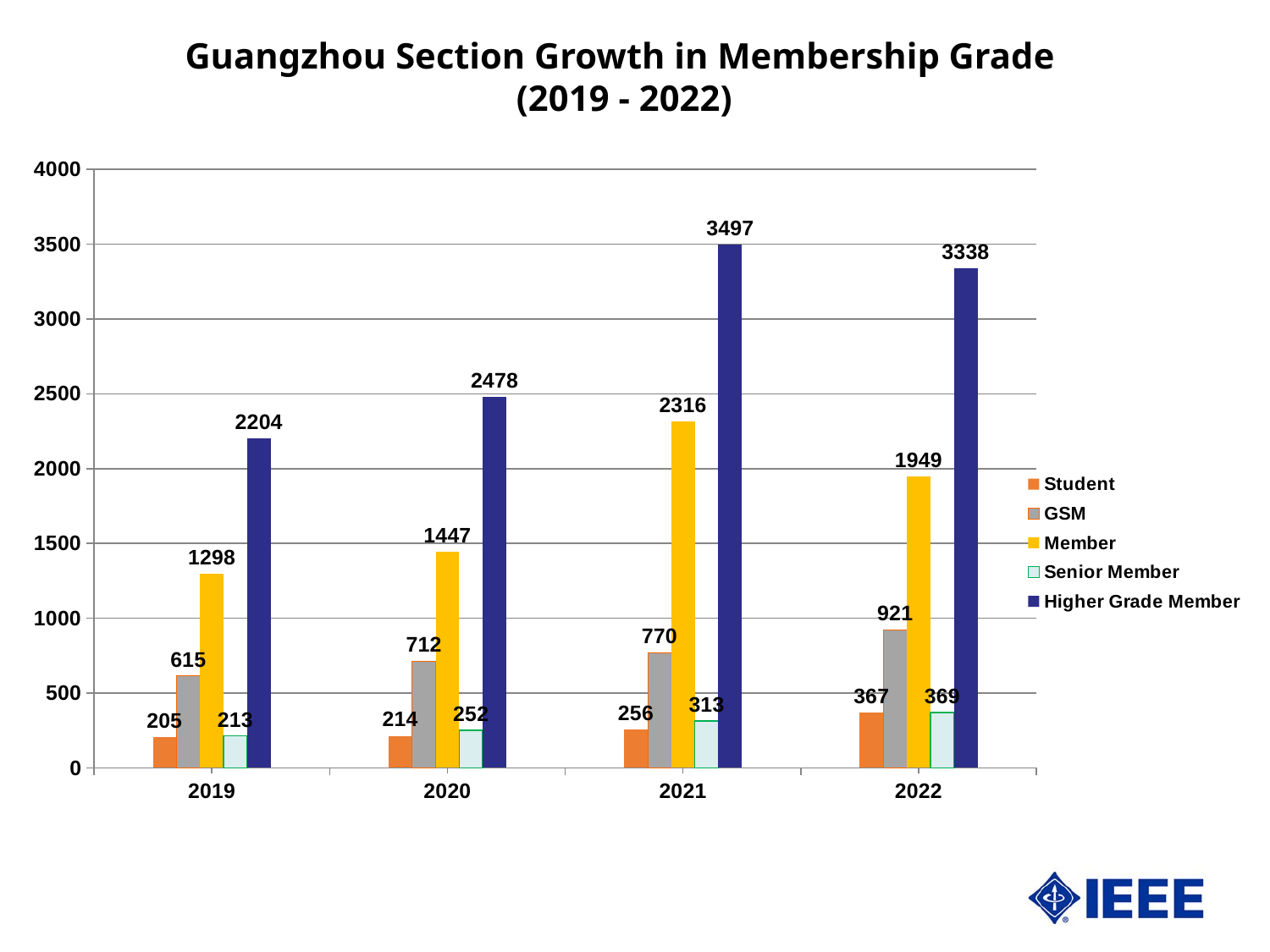
How many years are shown on the x axis? 4 What is the value for Member in 2020? 1447 What is the value for Higher Grade Member in 2021? 3497 Does the GSM value rise or fall from 2019 to 2022? Rise In which year is the Student value lowest? 2019 What is the value for GSM in 2022? 921 Which is larger, the Member value in 2021 or the Member value in 2022? Member in 2021 What kind of chart is shown on the slide? Bar chart In which year is the Higher Grade Member value highest? 2021 What is the difference between the Higher Grade Member values in 2021 and 2022? 159 What is the value for Senior Member in 2019? 213 How many series does the legend list? 5